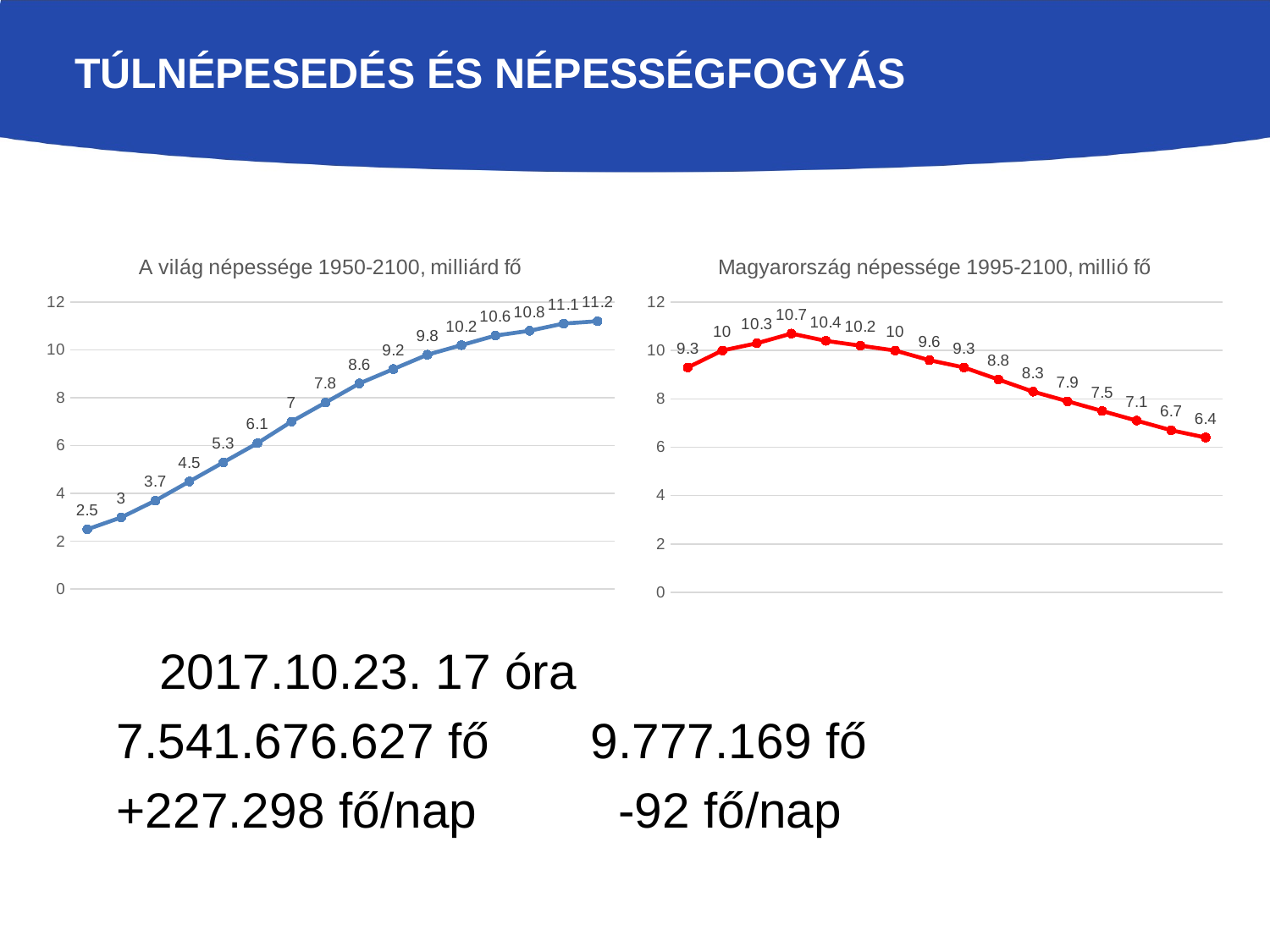
In the left chart 'A világ népessége 1950-2100, milliárd fő', what is the highest value plotted? 11.2 In the left chart 'A világ népessége 1950-2100, milliárd fő', what is the difference between the last data point and the first data point? 8.7 In the right chart 'Magyarország népessége 1995-2100, millió fő', what is the lowest value plotted? 6.4 In the right chart 'Magyarország népessége 1995-2100, millió fő', what is the highest value plotted? 10.7 In the right chart 'Magyarország népessége 1995-2100, millió fő', what is the difference between the highest value and the last data point? 4.3 What type of chart is the left chart titled 'A világ népessége 1950-2100, milliárd fő'? line chart In the right chart 'Magyarország népessége 1995-2100, millió fő', what is the value of the first data point? 9.3 In the left chart 'A világ népessége 1950-2100, milliárd fő', what is the value of the first data point? 2.5 In the left chart 'A világ népessége 1950-2100, milliárd fő', what is the value of the last data point? 11.2 How many data points are plotted in the left chart 'A világ népessége 1950-2100, milliárd fő'? 16 Which chart has the higher final data point, the left chart 'A világ népessége 1950-2100, milliárd fő' or the right chart 'Magyarország népessége 1995-2100, millió fő'? A világ népessége 1950-2100, milliárd fő In the left chart 'A világ népessége 1950-2100, milliárd fő', do the values rise or fall along the x axis? rise